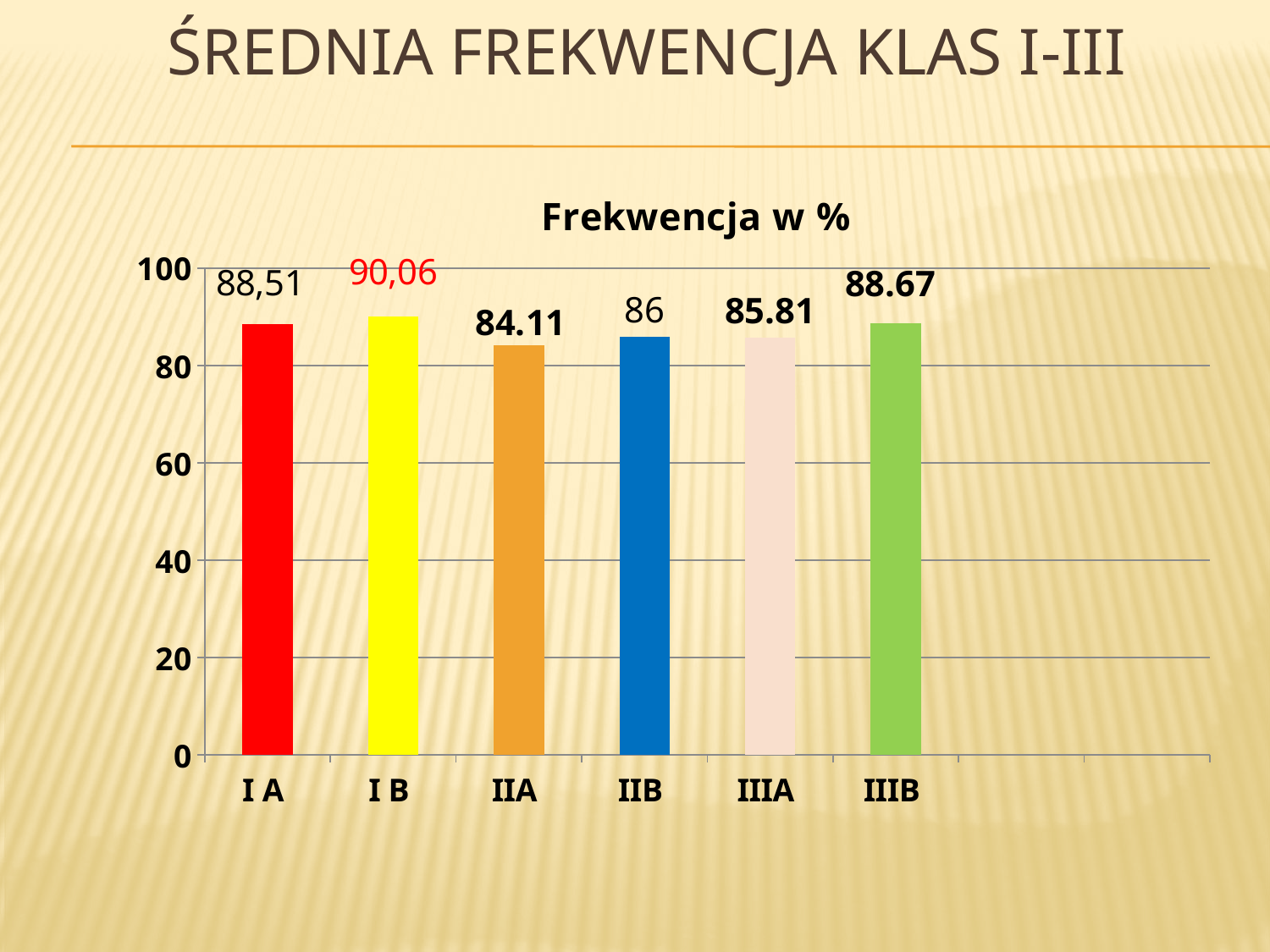
What is the value for I B? 90,06 What kind of chart is shown on the slide? Bar chart Which class has the highest value? I B What is the difference between the values for IIB and IIA? 1.89 What is the value for IIA? 84.11 What is the value for IIIB? 88.67 How many classes are shown on the chart? 6 Which is larger, the value for I B or the value for IIA? I B What is the value for IIIA? 85.81 What is the value for I A? 88,51 Which class has the lowest value? IIA What is the value for IIB? 86